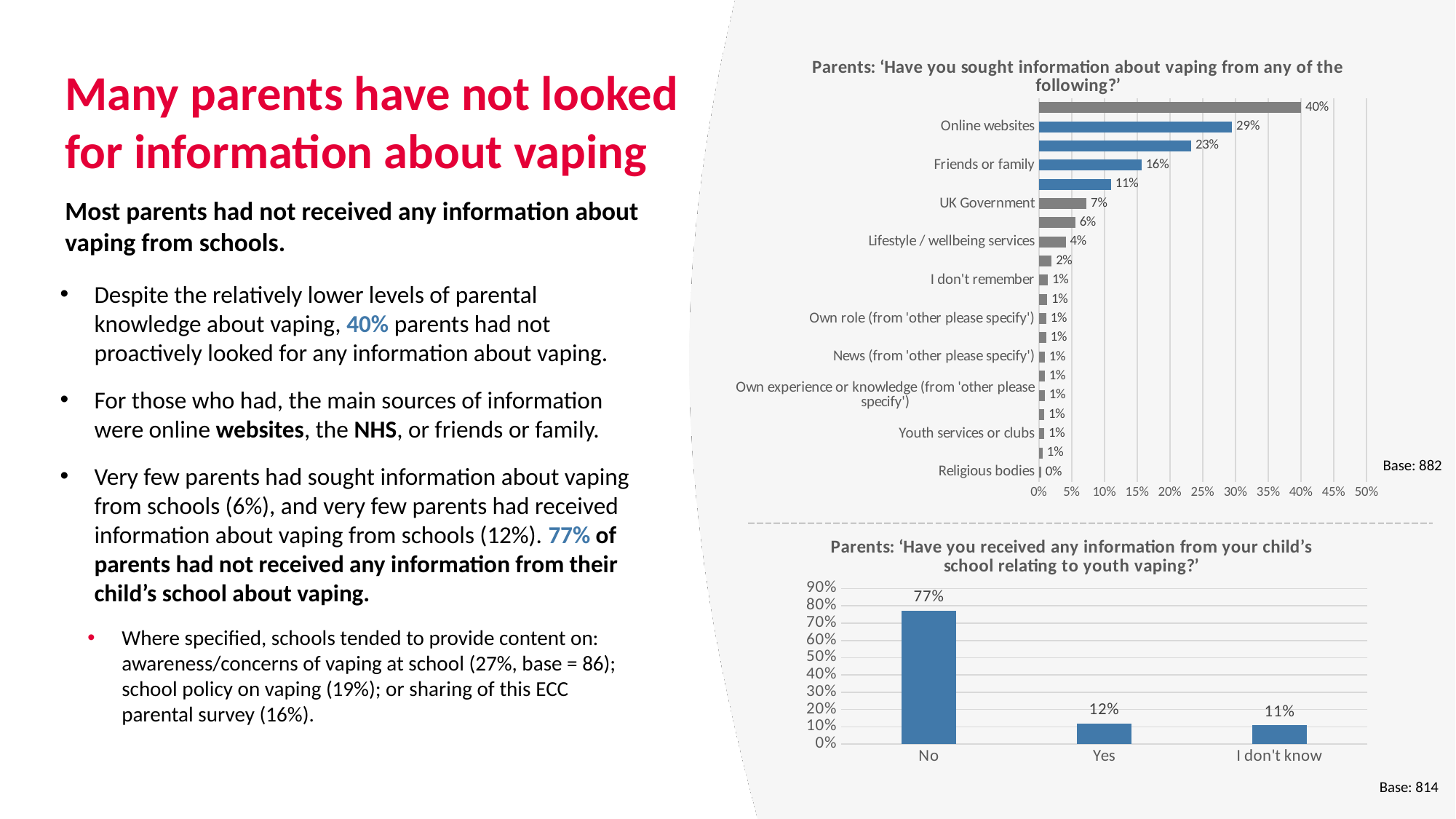
In the bottom chart, what is the difference between the 'No' and 'Yes' percentages? 65% In the top chart, which is larger: the value for online websites or the value for friends or family? Online websites In the bottom chart, what percentage of parents answered 'I don't know'? 11% In the top chart, what percentage of parents sought information from the UK Government? 7% How many response categories are shown in the bottom chart? 3 In the bottom chart ('Have you received any information from your child's school relating to youth vaping?'), what percentage of parents answered 'No'? 77% In the bottom chart, which response has the highest value? No What type of chart is the bottom chart? Bar chart In the top chart, what percentage of parents sought information from friends or family? 16% In the top chart, what percentage of parents sought information from religious bodies? 0% In the top chart ('Have you sought information about vaping from any of the following?'), what percentage of parents sought information from online websites? 29% In the bottom chart, what percentage of parents answered 'Yes'? 12%